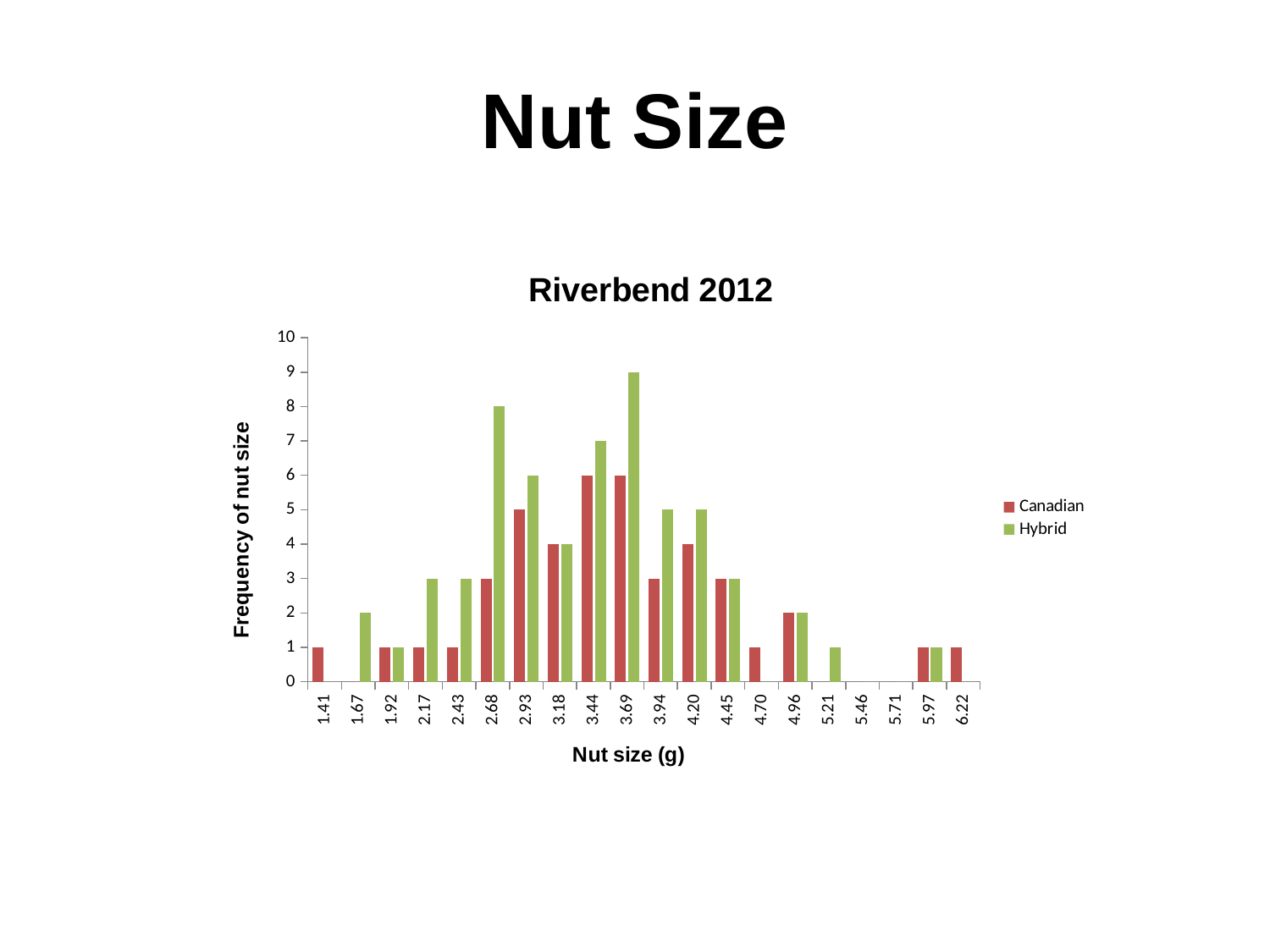
What is the difference between the Hybrid and Canadian frequencies at nut size 2.68? 5 What is the Canadian frequency at nut size 2.93? 5 What is the title of the chart? Riverbend 2012 Is the Hybrid frequency at nut size 3.69 greater or less than 8? greater What kind of chart is shown on the slide? Bar chart What is the Hybrid frequency at nut size 3.69? 9 What is the Canadian frequency at nut size 4.96? 2 What is the Hybrid frequency at nut size 2.68? 8 How many series does the legend list? 2 At nut size 3.94, which series has the larger frequency, Canadian or Hybrid? Hybrid At which nut size is the Hybrid frequency highest? 3.69 How many nut size categories are shown on the x axis? 20